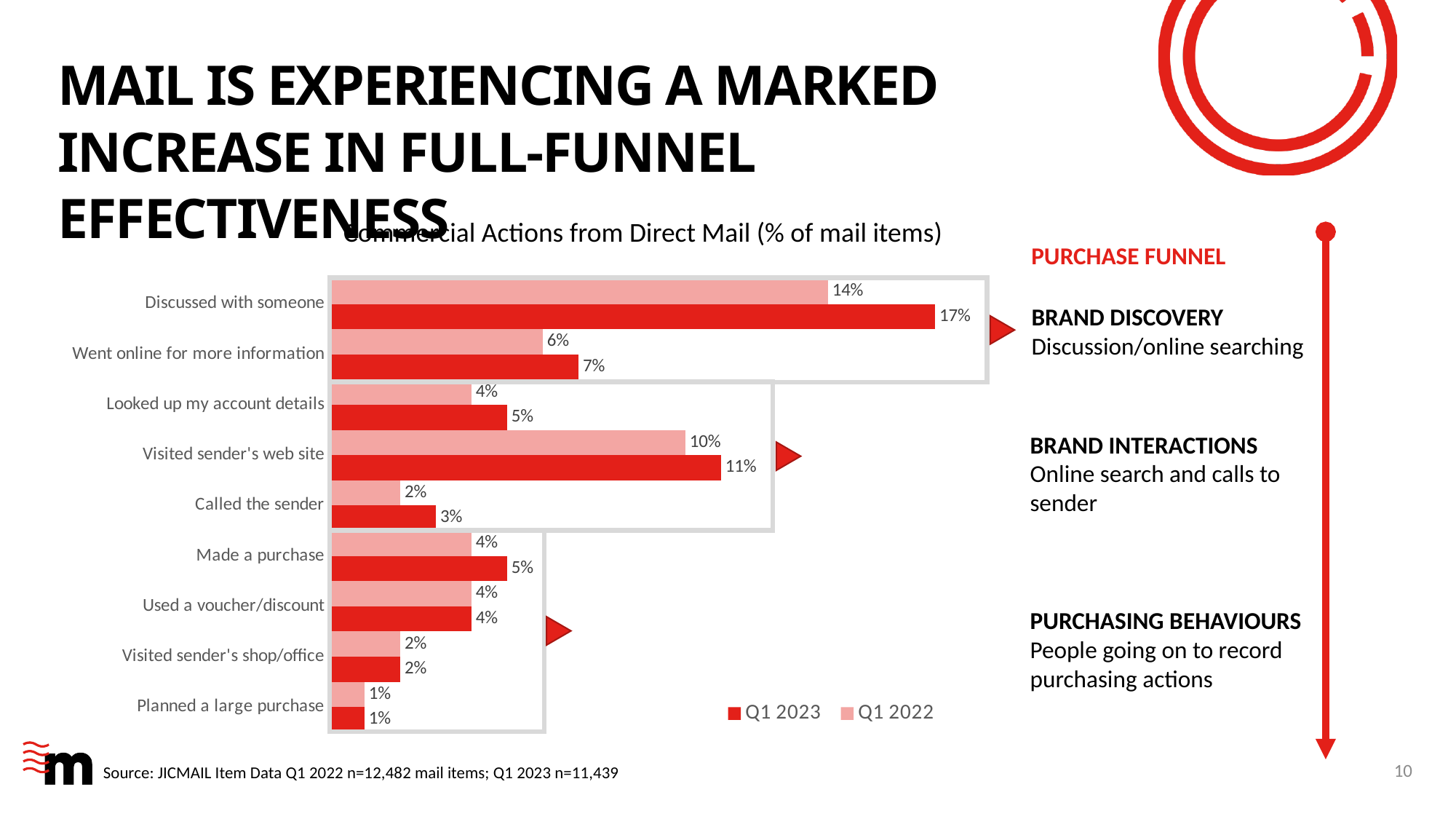
What is the Q1 2022 value for "Went online for more information"? 6% How many series does the legend list? 2 How many categories are shown in the chart? 9 What is the Q1 2022 value for "Visited sender's web site"? 10% What are the two series named in the chart legend? Q1 2023 and Q1 2022 What is the difference between the Q1 2023 and Q1 2022 values for "Discussed with someone"? 3% Which is larger for "Visited sender's web site": the Q1 2023 value or the Q1 2022 value? Q1 2023 What is the Q1 2023 value for "Discussed with someone"? 17% Which category has the lowest Q1 2022 value? Planned a large purchase What is the Q1 2023 value for "Called the sender"? 3% Which category has the highest Q1 2023 value? Discussed with someone What kind of chart is shown on the slide? Bar chart